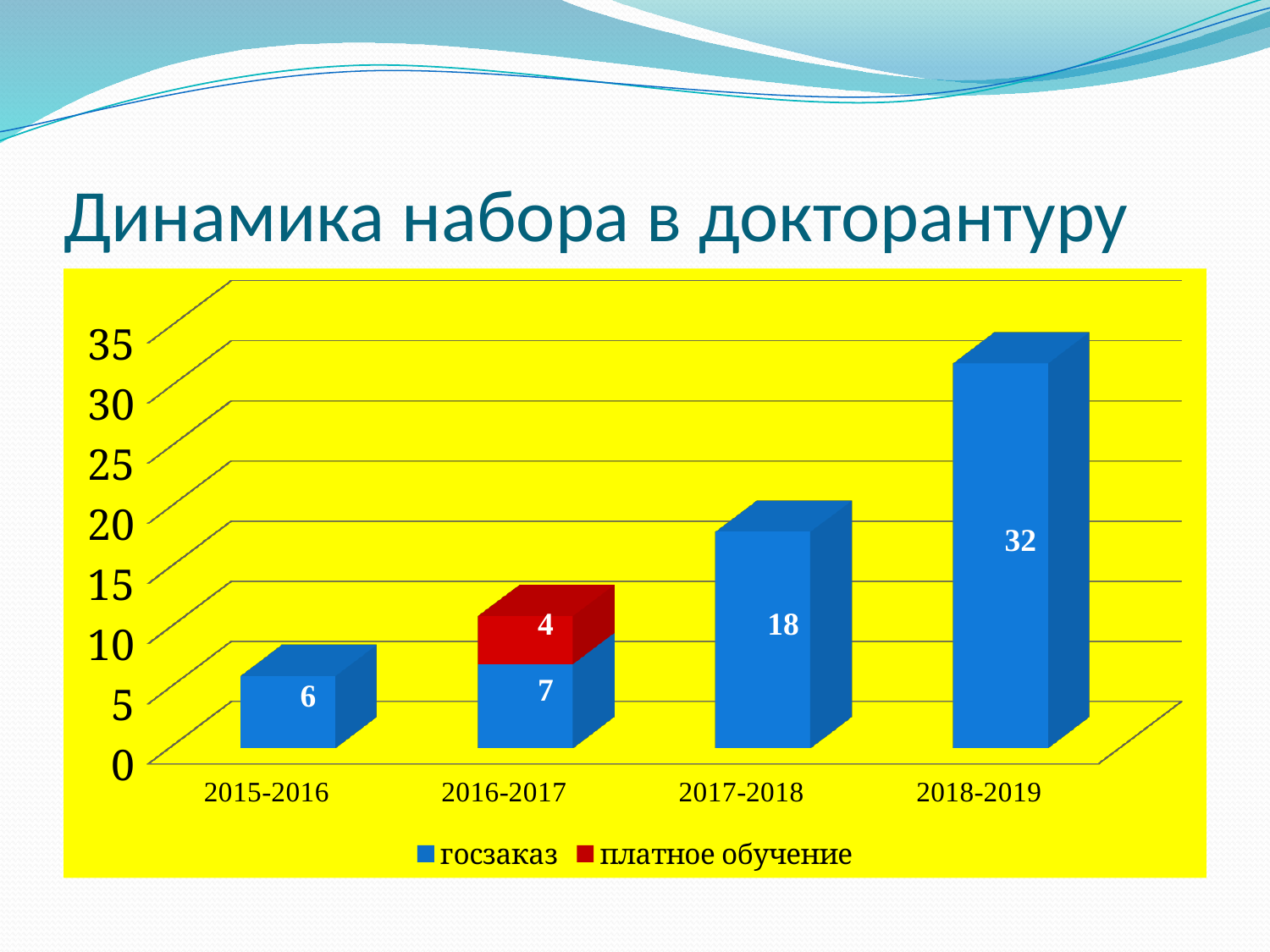
Which year has the highest value for госзаказ? 2018-2019 Does the госзаказ value rise or fall from 2015-2016 to 2018-2019? rise What is the value for госзаказ in 2015-2016? 6 What is the value for платное обучение in 2016-2017? 4 How many year categories are shown on the x axis? 4 What kind of chart is shown on the slide? bar chart Which is larger, the госзаказ value for 2016-2017 or for 2017-2018? 2017-2018 What is the total of the stacked bar for 2016-2017? 11 How many series does the legend list? 2 What is the difference between the госзаказ values for 2018-2019 and 2017-2018? 14 Which year has the lowest value for госзаказ? 2015-2016 What is the value for госзаказ in 2018-2019? 32